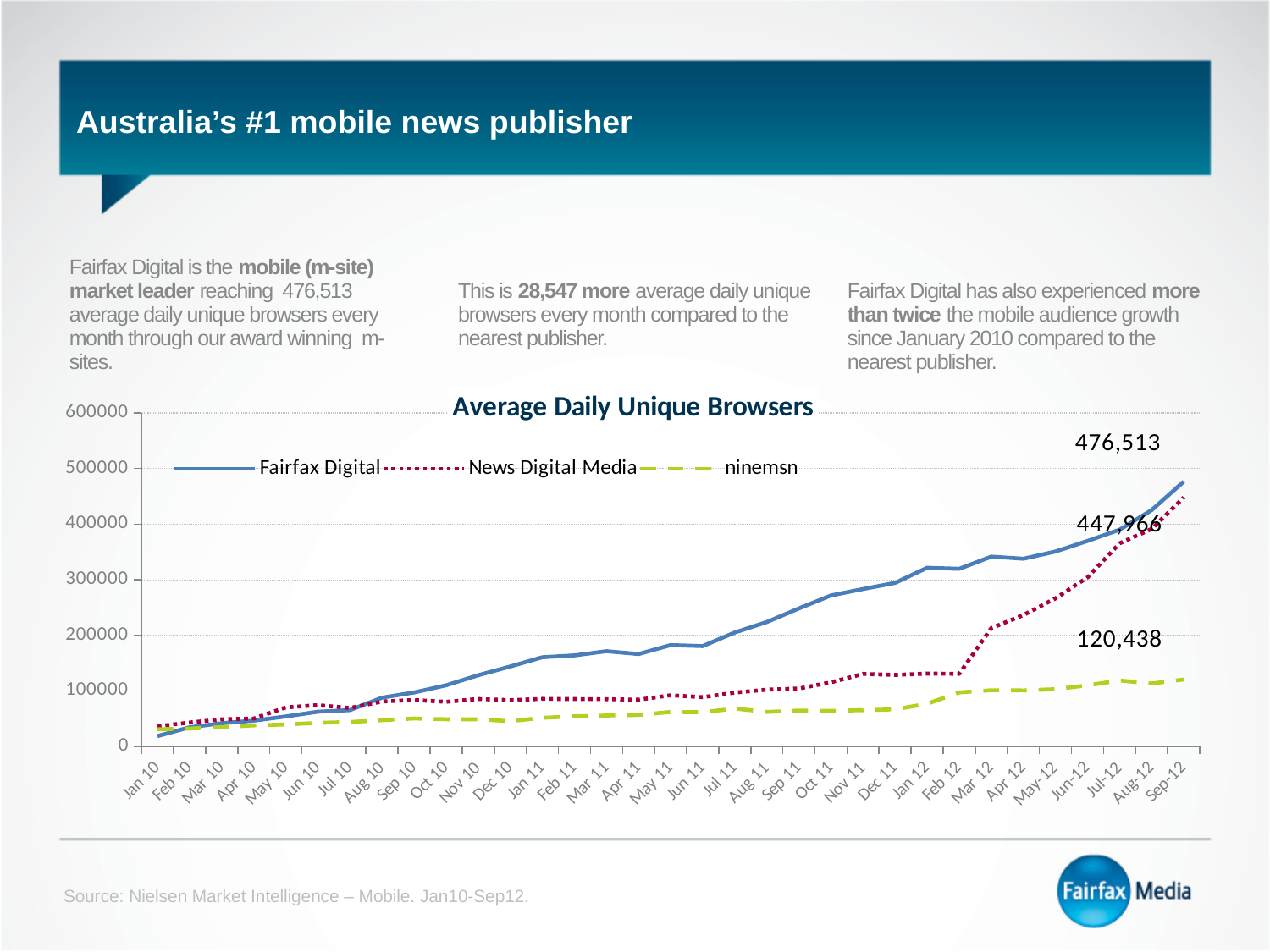
What is the value for Fairfax Digital in Sep 12? 476,513 What is the value for News Digital Media in Sep 12? 447,966 What is the difference between the Fairfax Digital and News Digital Media values in Sep 12? 28,547 Which series has the lowest value in Sep 12? ninemsn Is the value for Fairfax Digital in Jan 12 greater or less than 300000? greater What is the difference between the Fairfax Digital and ninemsn values in Sep 12? 356,075 Which series has the highest value in Sep 12? Fairfax Digital What is the value for ninemsn in Sep 12? 120,438 What is the title of the chart? Average Daily Unique Browsers What type of chart is shown on the slide? line chart Does the Fairfax Digital series generally rise or fall from Jan 10 to Sep 12? rise How many series does the chart legend list? 3